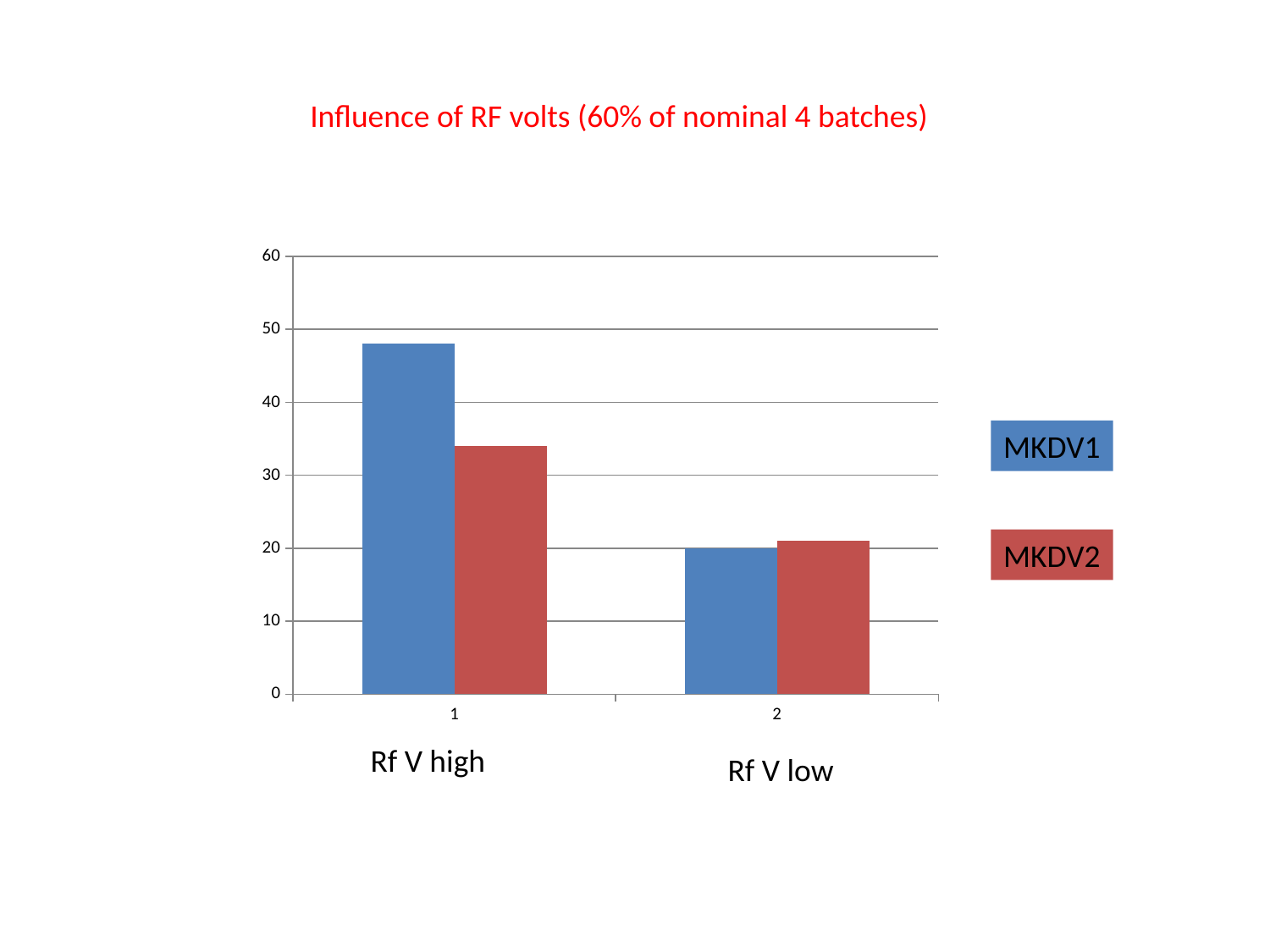
How many categories are shown on the x axis? 2 What kind of chart is shown on the slide? bar chart Which category has the highest MKDV1 value? Rf V high How many series does the legend list? 2 What is the title of the chart? Influence of RF volts (60% of nominal 4 batches) What colour represents the MKDV2 series? red Is the MKDV1 value for Rf V low greater or less than 30? less Is the MKDV1 value for Rf V high greater or less than 40? greater Do the MKDV1 values rise or fall from Rf V high to Rf V low? fall Is the MKDV2 value for Rf V high greater or less than 30? greater For Rf V high, which series has the larger value, MKDV1 or MKDV2? MKDV1